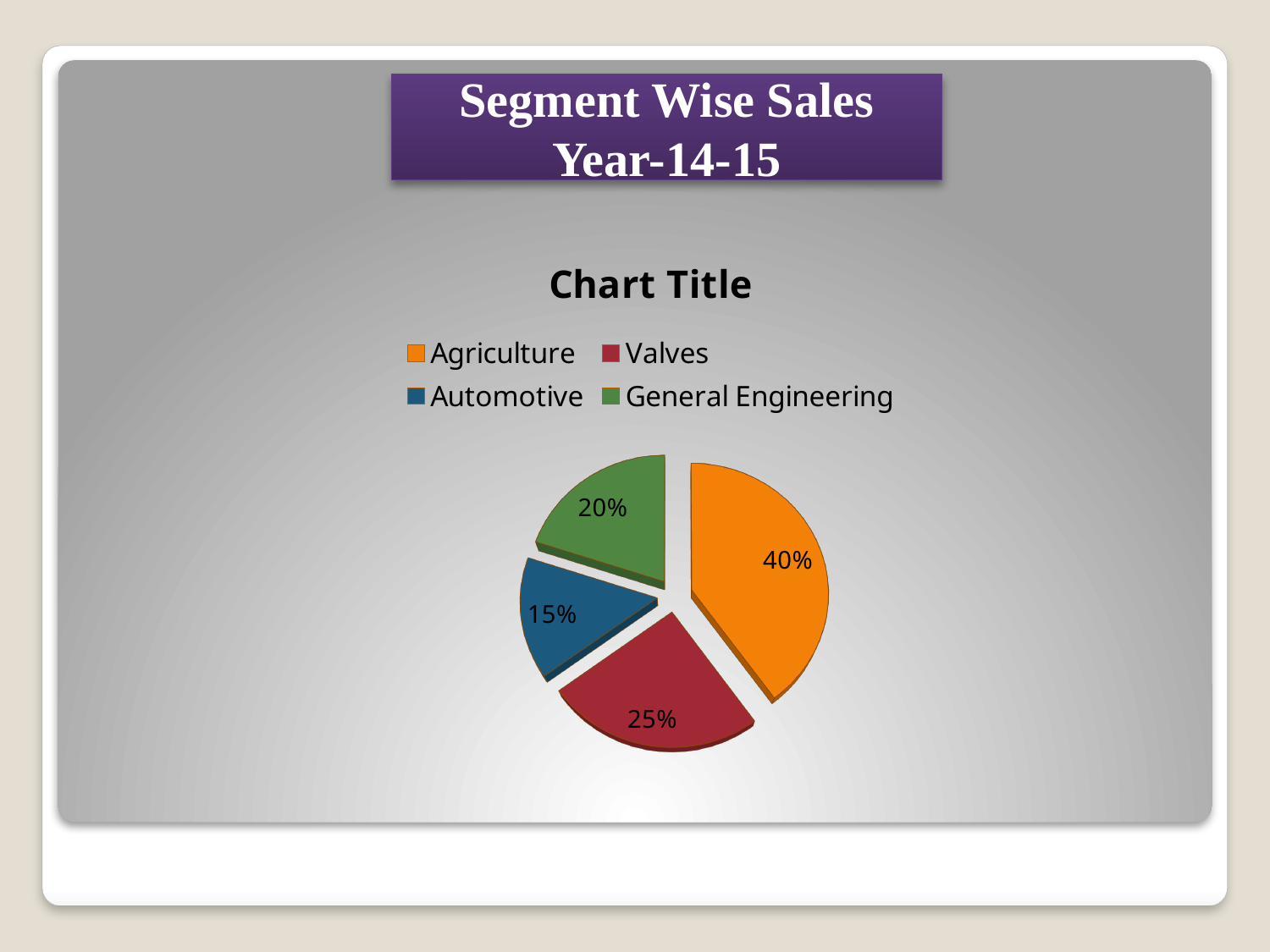
How many segments are shown in the pie chart? 4 What is the difference in percentage points between Agriculture and Valves? 15% What share of the pie does General Engineering have? 20% What share of the pie does Agriculture have? 40% What is the difference in percentage points between General Engineering and Automotive? 5% Which segment has the smallest share of the pie? Automotive What kind of chart is shown on the slide? Pie chart Which segment has the largest share of the pie? Agriculture What colour is the Agriculture slice in the pie chart? Orange Which has a larger share, Valves or General Engineering? Valves What share of the pie does Automotive have? 15%